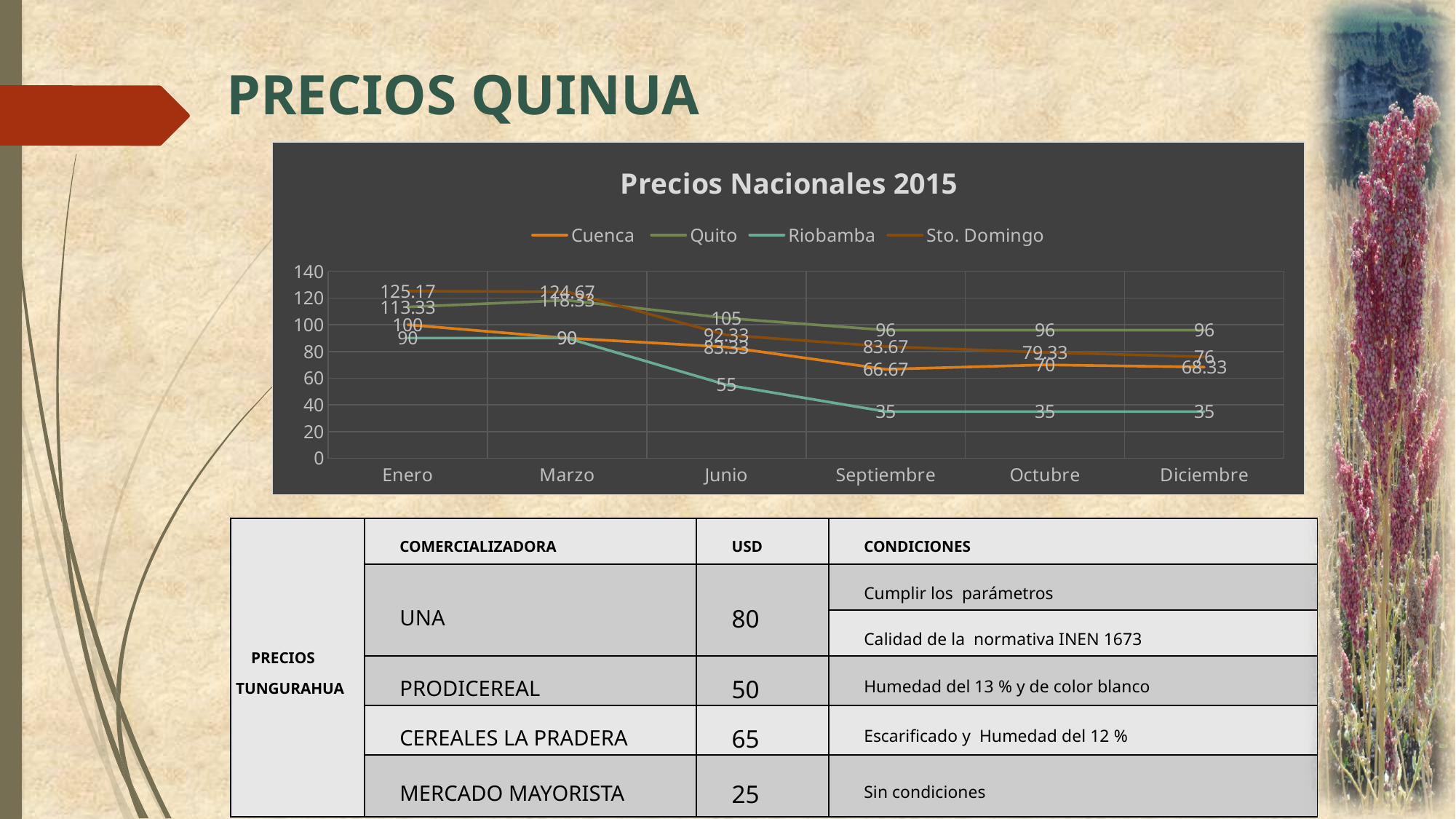
What is the title of the chart? Precios Nacionales 2015 How many months are shown along the x axis of the chart? 6 What is the value for Quito in Junio? 105 What kind of chart is shown on the slide? line chart Which series has the highest value in Diciembre? Quito What is the value for Sto. Domingo in Enero? 125.17 What is the value for Riobamba in Junio? 55 What is the value for Cuenca in Septiembre? 66.67 Which series has the lowest value in Septiembre? Riobamba What is the difference between the Quito and Riobamba values in Diciembre? 61 How many series does the legend of the chart list? 4 Does the Riobamba line rise or fall from Enero to Diciembre? fall